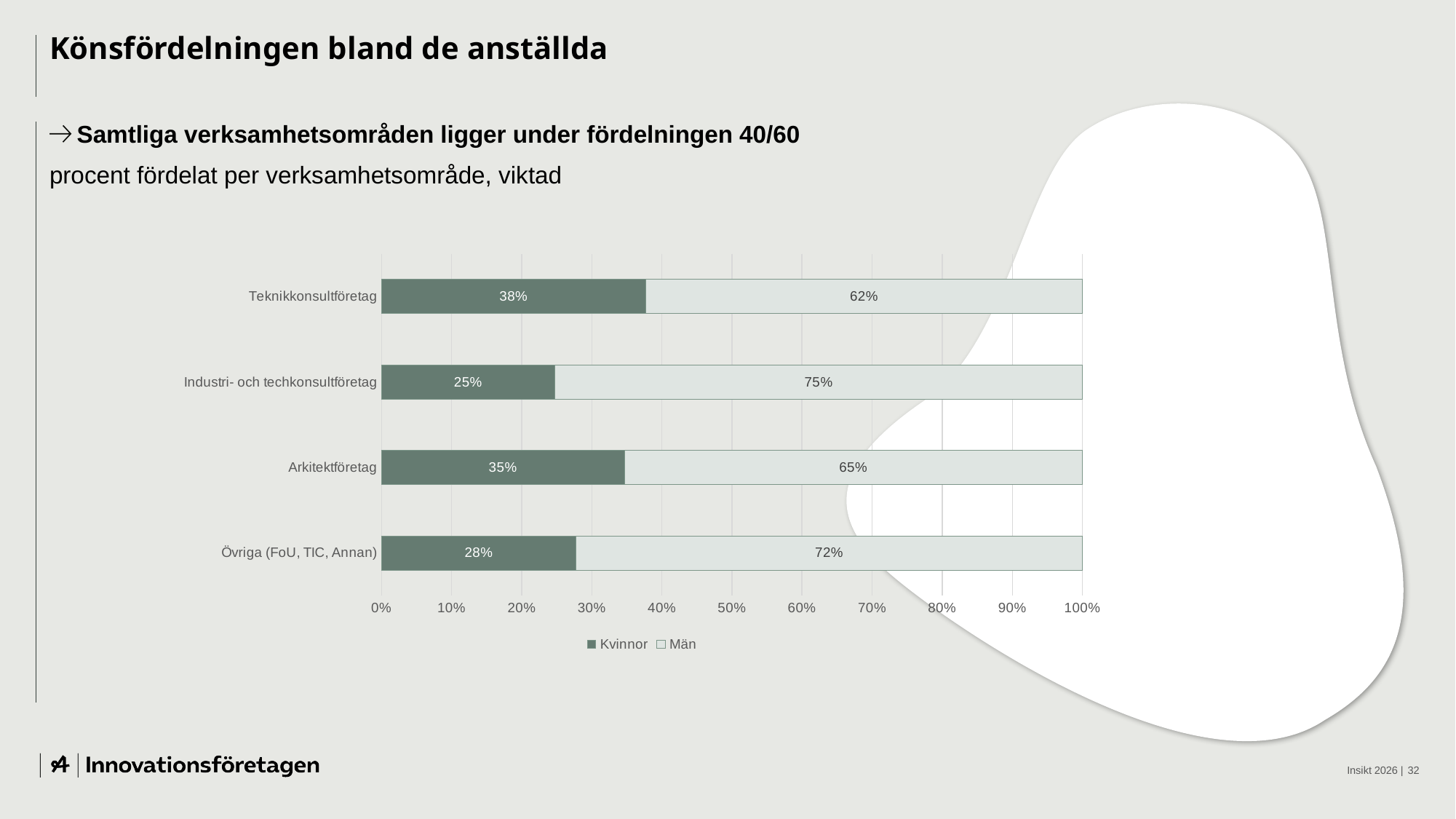
Which is larger: the Kvinnor value for Övriga (FoU, TIC, Annan) or for Industri- och techkonsultföretag? Övriga (FoU, TIC, Annan) What is the Män value for Industri- och techkonsultföretag? 75% How many categories are shown on the chart? 4 What is the total of the stacked bar for Teknikkonsultföretag? 100% How many series does the legend list? 2 What is the Kvinnor value for Teknikkonsultföretag? 38% What is the difference between the Män and Kvinnor values for Arkitektföretag? 30% Which category has the highest Kvinnor share? Teknikkonsultföretag Which category has the lowest Kvinnor share? Industri- och techkonsultföretag What is the Kvinnor value for Arkitektföretag? 35% What is the Män value for Övriga (FoU, TIC, Annan)? 72% What kind of chart is shown on the slide? Stacked bar chart